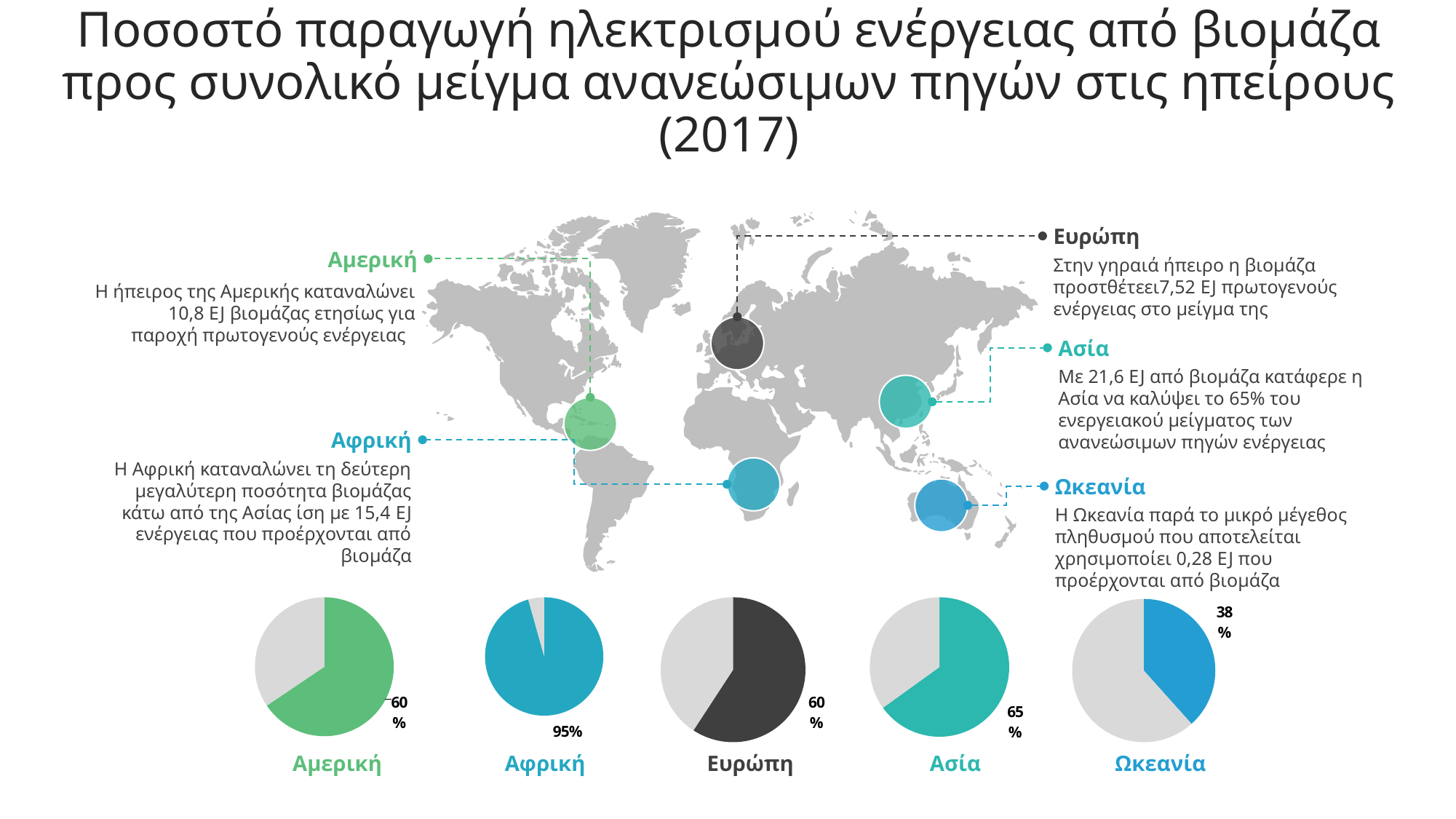
What kind of chart is used for each continent at the bottom of the slide? Pie chart In the pie chart labelled Ευρώπη, what share is shown for the coloured slice? 60% In the pie chart labelled Ωκεανία, what share is shown for the coloured slice? 38% In the pie chart labelled Αμερική, what share is shown for the coloured slice? 60% Which continent's pie chart shows the highest biomass share? Αφρική How many pie charts are shown on the slide? 5 Which continent's pie chart shows the lowest biomass share? Ωκεανία Which shows a larger share: the Ασία pie chart or the Ευρώπη pie chart? Ασία What is the difference between the share shown in the Αφρική pie chart and the share shown in the Ωκεανία pie chart? 57% In the pie chart labelled Ασία, what share is shown for the coloured slice? 65% In the pie chart labelled Αφρική, what share is shown for the coloured slice? 95% What colour is the main slice in the Ευρώπη pie chart? Dark grey